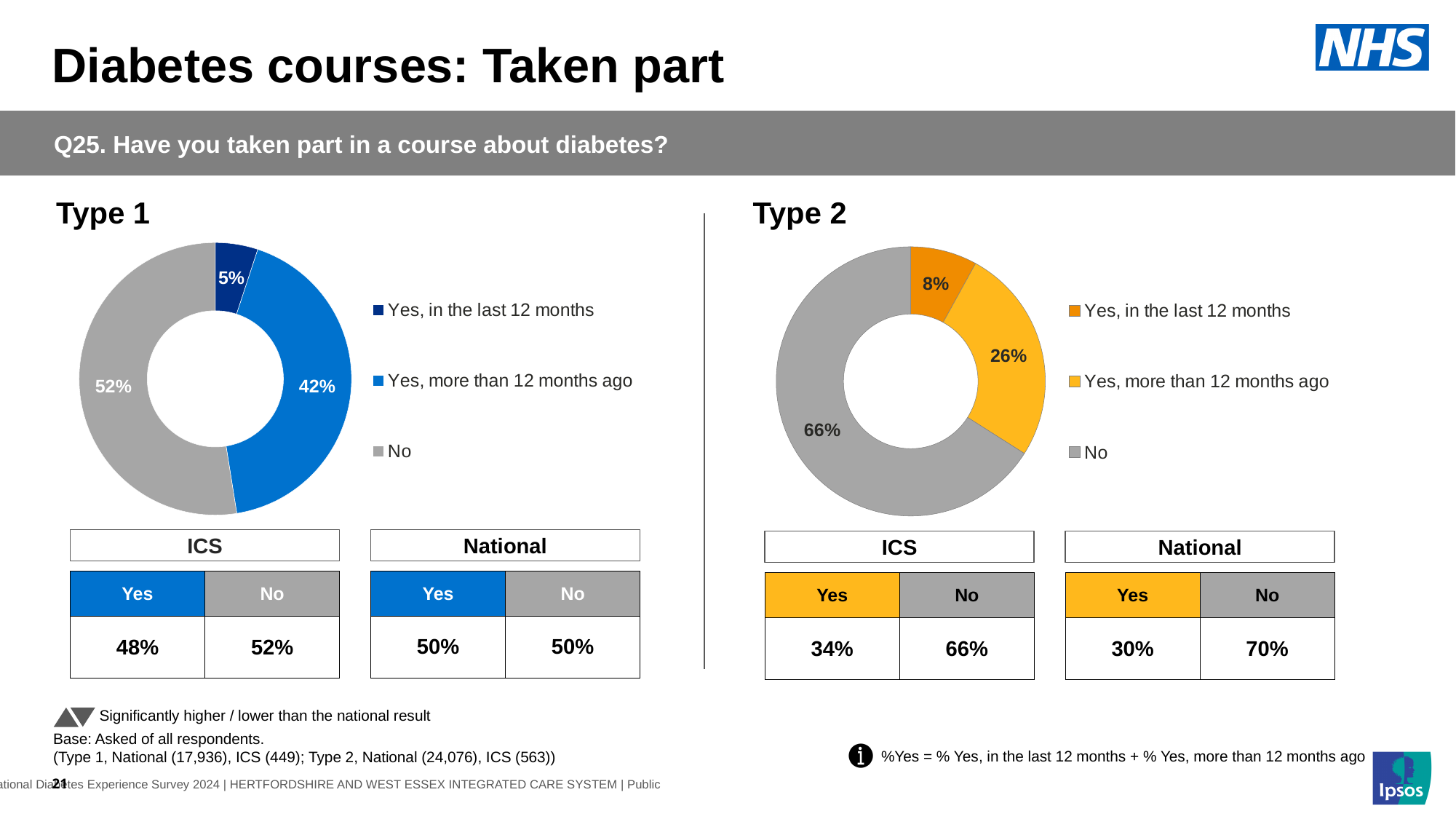
How many legend entries does the Type 2 chart list? 3 In the Type 2 chart, which response has the smallest share? Yes, in the last 12 months In the Type 1 chart, what percentage of respondents answered 'Yes, in the last 12 months'? 5% Which is larger: the 'Yes, in the last 12 months' share in the Type 1 chart or in the Type 2 chart? Type 2 In the Type 1 chart, which response has the largest share? No How many categories does the Type 1 chart show? 3 In the Type 2 chart, what percentage of respondents answered 'Yes, more than 12 months ago'? 26% What kind of chart is used for Type 2? Doughnut chart In the Type 1 chart, what colour represents 'No'? Grey In the Type 2 chart, what is the difference in percentage points between 'No' and 'Yes, more than 12 months ago'? 40 In the Type 1 chart, what percentage of respondents answered 'Yes, more than 12 months ago'? 42% In the Type 2 chart, what percentage of respondents answered 'No'? 66%